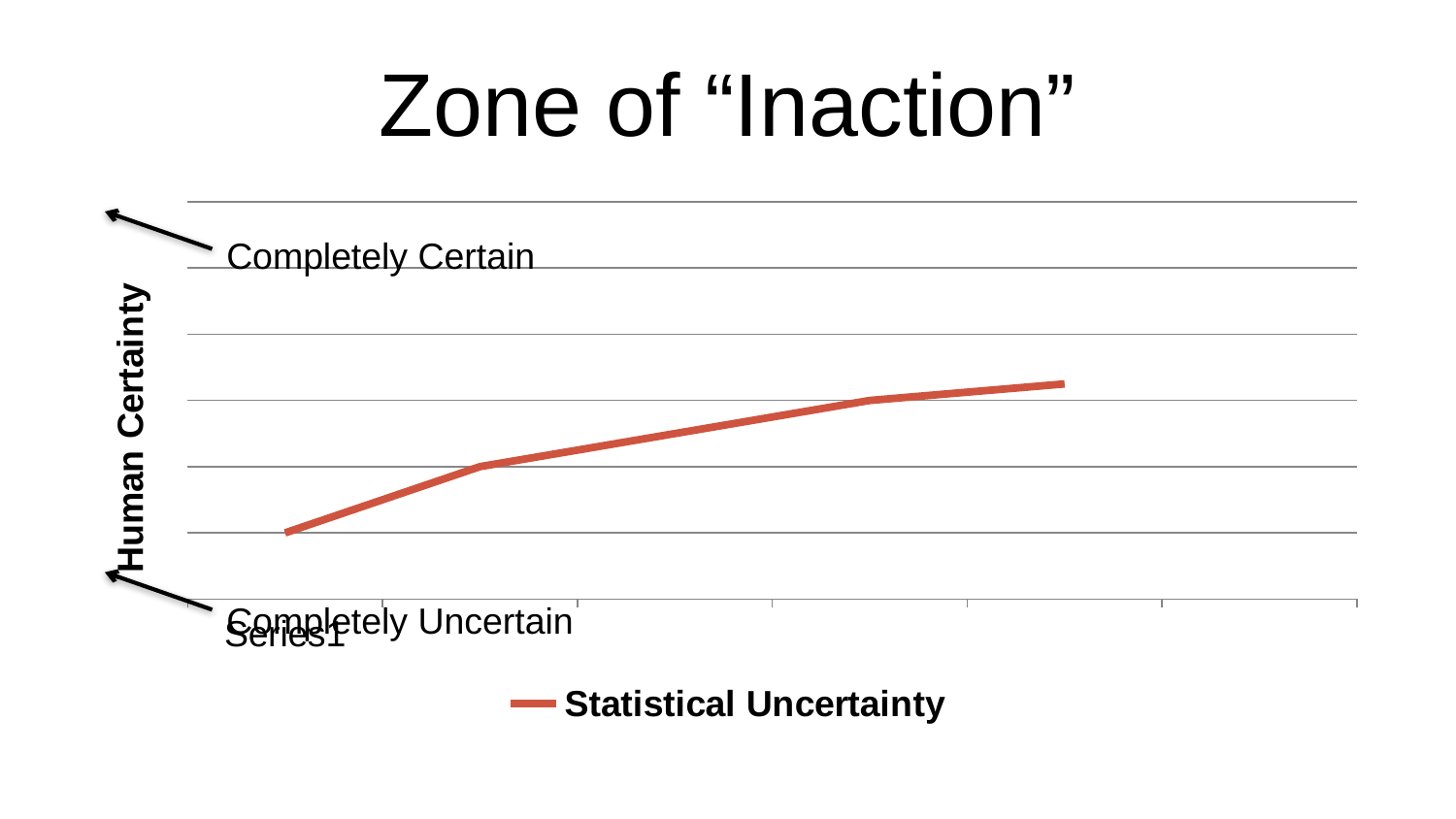
How many series does the legend list? 1 What is the name of the series shown in the legend? Statistical Uncertainty What is the label on the vertical axis of the chart? Human Certainty Does the Statistical Uncertainty line rise or fall from left to right? rise What kind of chart is shown on the slide? line chart